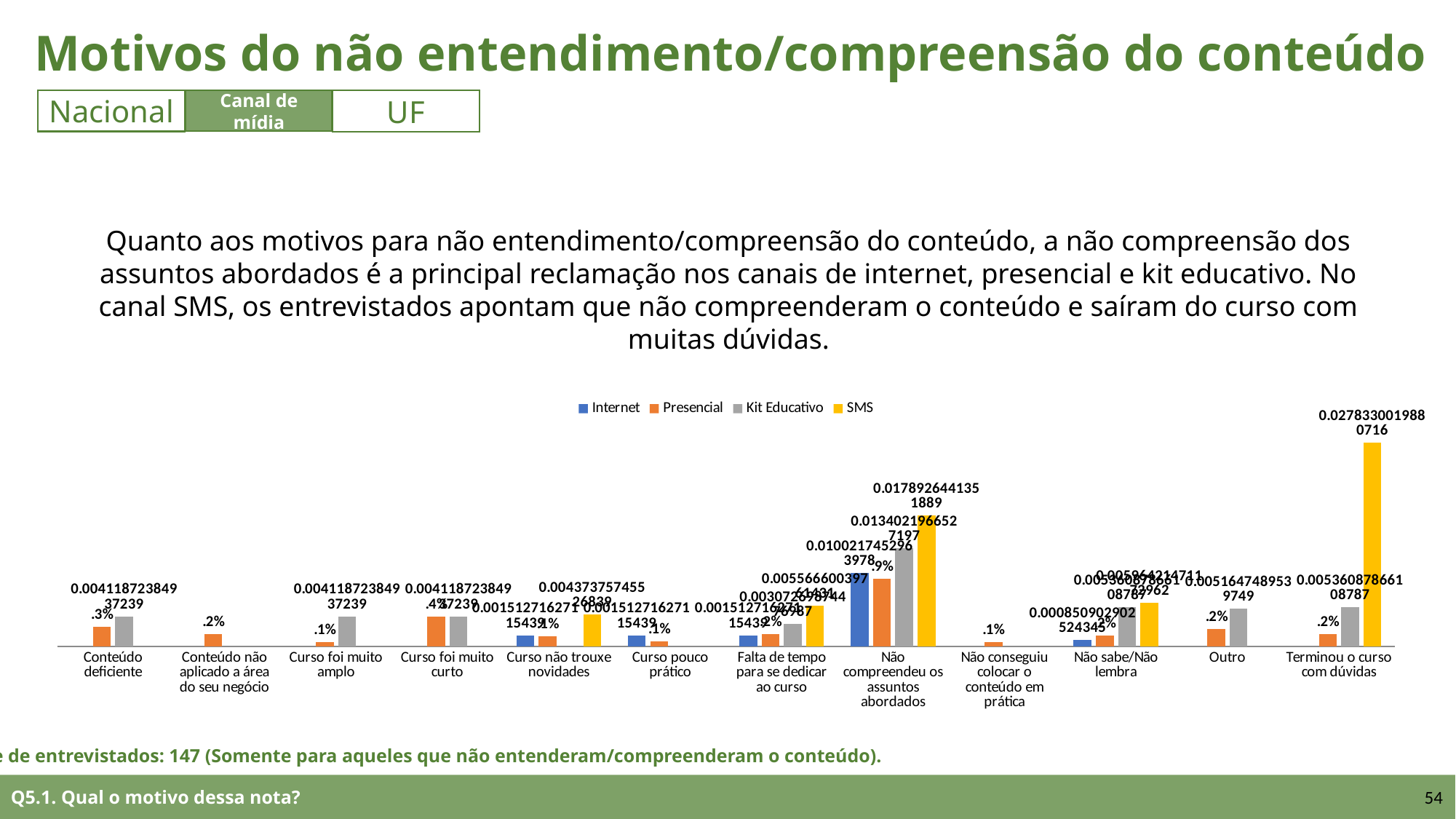
Which is larger for 'Conteúdo deficiente': the Presencial bar or the Kit Educativo bar? Kit Educativo What is the Presencial value for 'Conteúdo não aplicado a área do seu negócio'? .2% Which series has the tallest bar for 'Não compreendeu os assuntos abordados'? SMS Which is larger: the SMS bar for 'Terminou o curso com dúvidas' or the SMS bar for 'Não compreendeu os assuntos abordados'? Terminou o curso com dúvidas How many series does the chart legend list? 4 Which category has the tallest bar in the chart? Terminou o curso com dúvidas What is the Presencial value for 'Conteúdo deficiente'? .3% How many categories are shown along the x axis of the chart? 12 What colour represents the SMS series in the chart? yellow What kind of chart is shown on the slide? bar chart What is the SMS value for 'Terminou o curso com dúvidas'? 0.0278330019880716 What is the Presencial value for 'Curso foi muito curto'? .4%